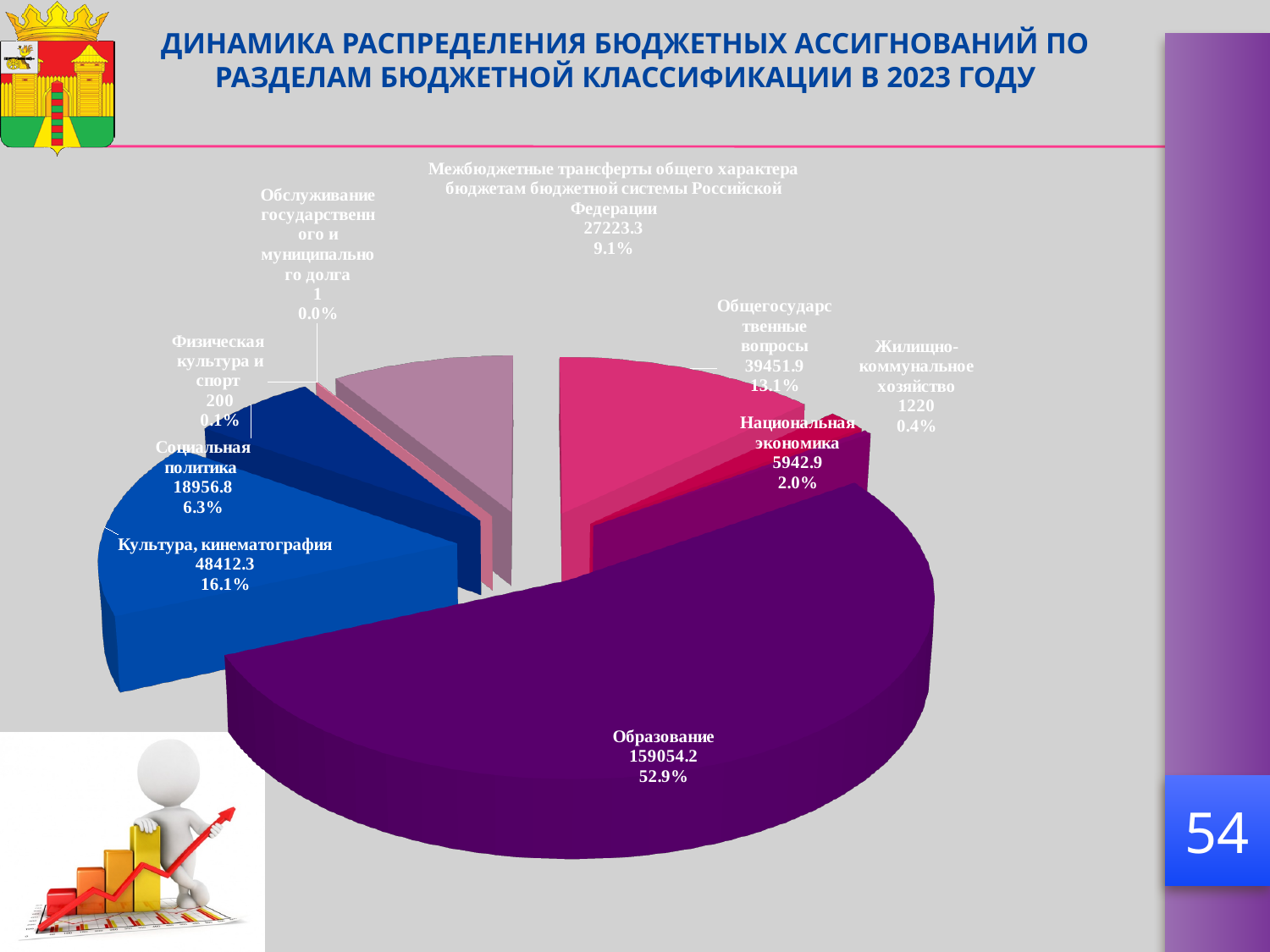
What value is shown for Культура, кинематография? 48412.3 What share of the pie does Образование represent? 52.9% What is the difference between the values for Общегосударственные вопросы and Межбюджетные трансферты общего характера бюджетам бюджетной системы Российской Федерации? 12228.6 What year does the chart title refer to? 2023 Which category has the largest slice of the pie? Образование What kind of chart is shown on the slide? pie chart What value is shown for Образование? 159054.2 What share of the pie does Общегосударственные вопросы represent? 13.1% Which category has the smallest value in the pie chart? Обслуживание государственного и муниципального долга Which is larger: the value for Национальная экономика or the value for Жилищно-коммунальное хозяйство? Национальная экономика What value is shown for Социальная политика? 18956.8 How many categories are shown in the pie chart? 9